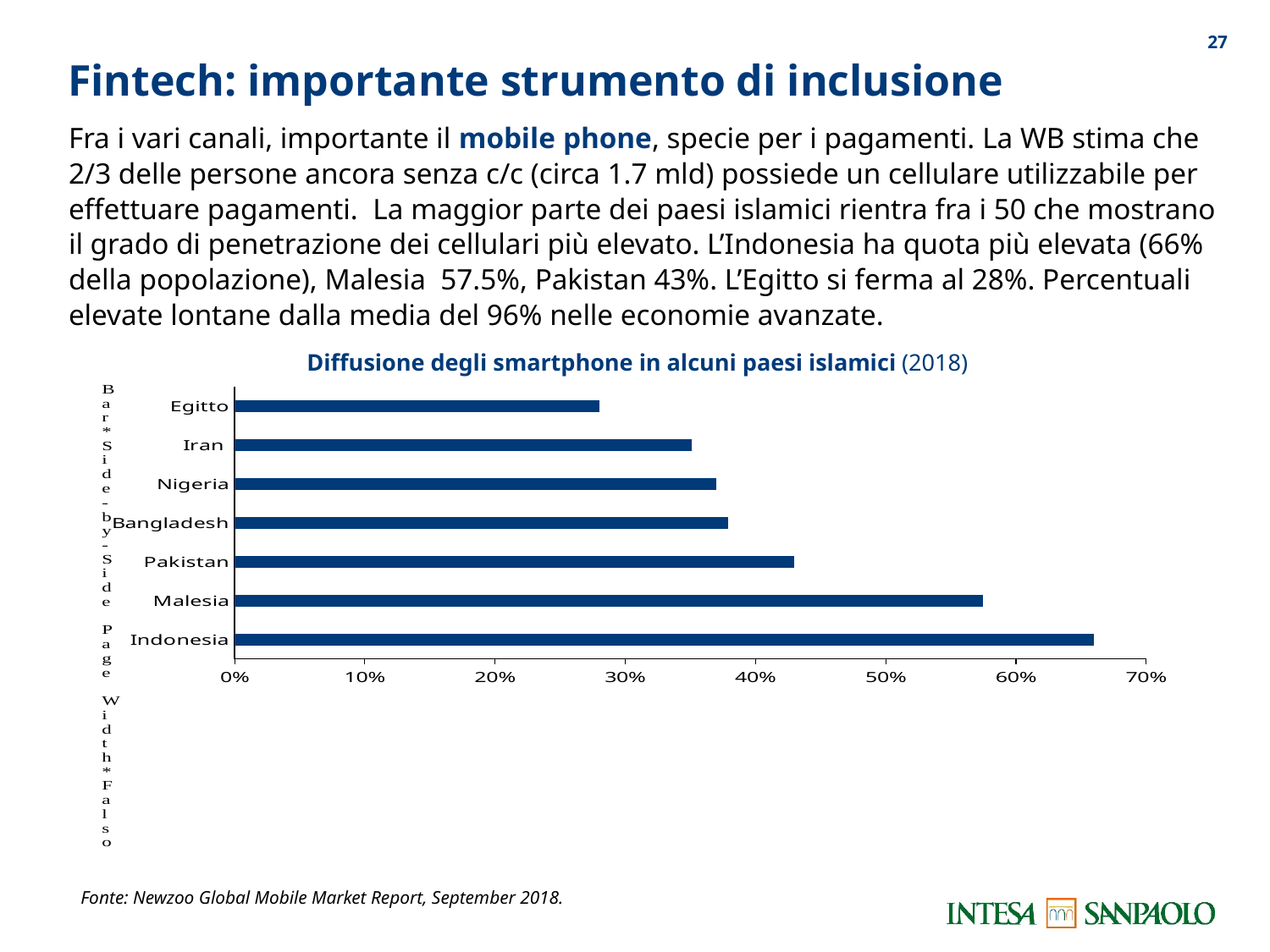
Is the value for Iran greater or less than 30%? greater What kind of chart is shown on the slide? bar chart Which country has the highest smartphone penetration in the chart? Indonesia Is the value for Pakistan greater or less than 40%? greater How many countries are shown in the chart? 7 Which country has the lowest smartphone penetration in the chart? Egitto Is the value for Malesia greater or less than 60%? less Which has the larger value, Malesia or Pakistan? Malesia What is the title of the chart? Diffusione degli smartphone in alcuni paesi islamici (2018)